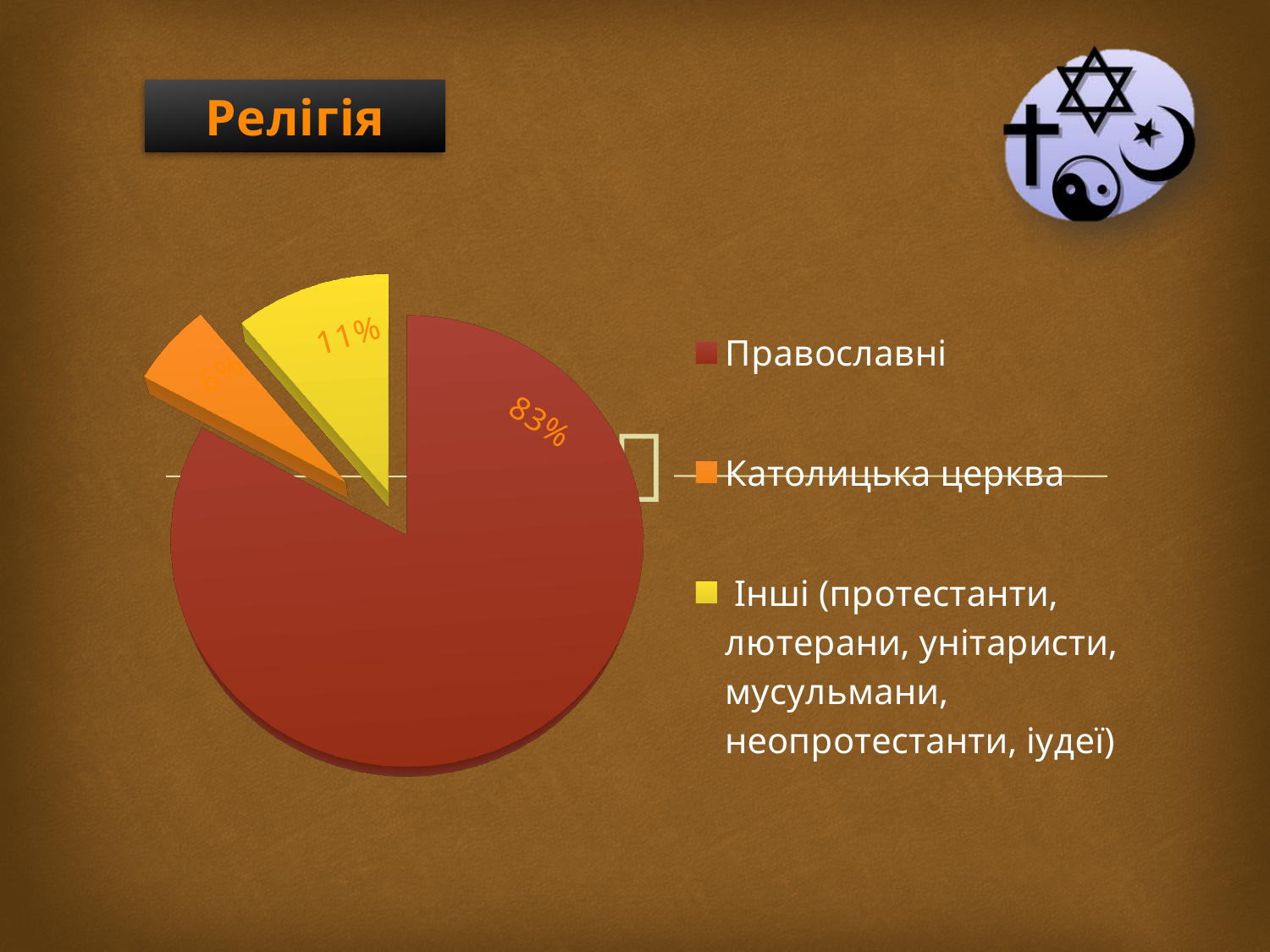
What colour is the Православні slice in the pie chart? red What is the difference in percentage points between the Православні slice and the Інші slice? 72 What is the title shown on the slide above the chart? Релігія Which category has the largest slice of the pie? Православні Which category has the smallest slice of the pie? Католицька церква What share of the pie does the Православні slice represent? 83% What share of the pie does the Інші (протестанти, лютерани, унітаристи, мусульмани, неопротестанти, іудеї) slice represent? 11% What kind of chart is shown on the slide? pie chart How many entries does the legend list? 3 Which is larger, the slice for Православні or the slice for Інші? Православні Which is larger, the slice for Католицька церква or the slice for Інші? Інші How many slices does the pie chart have? 3